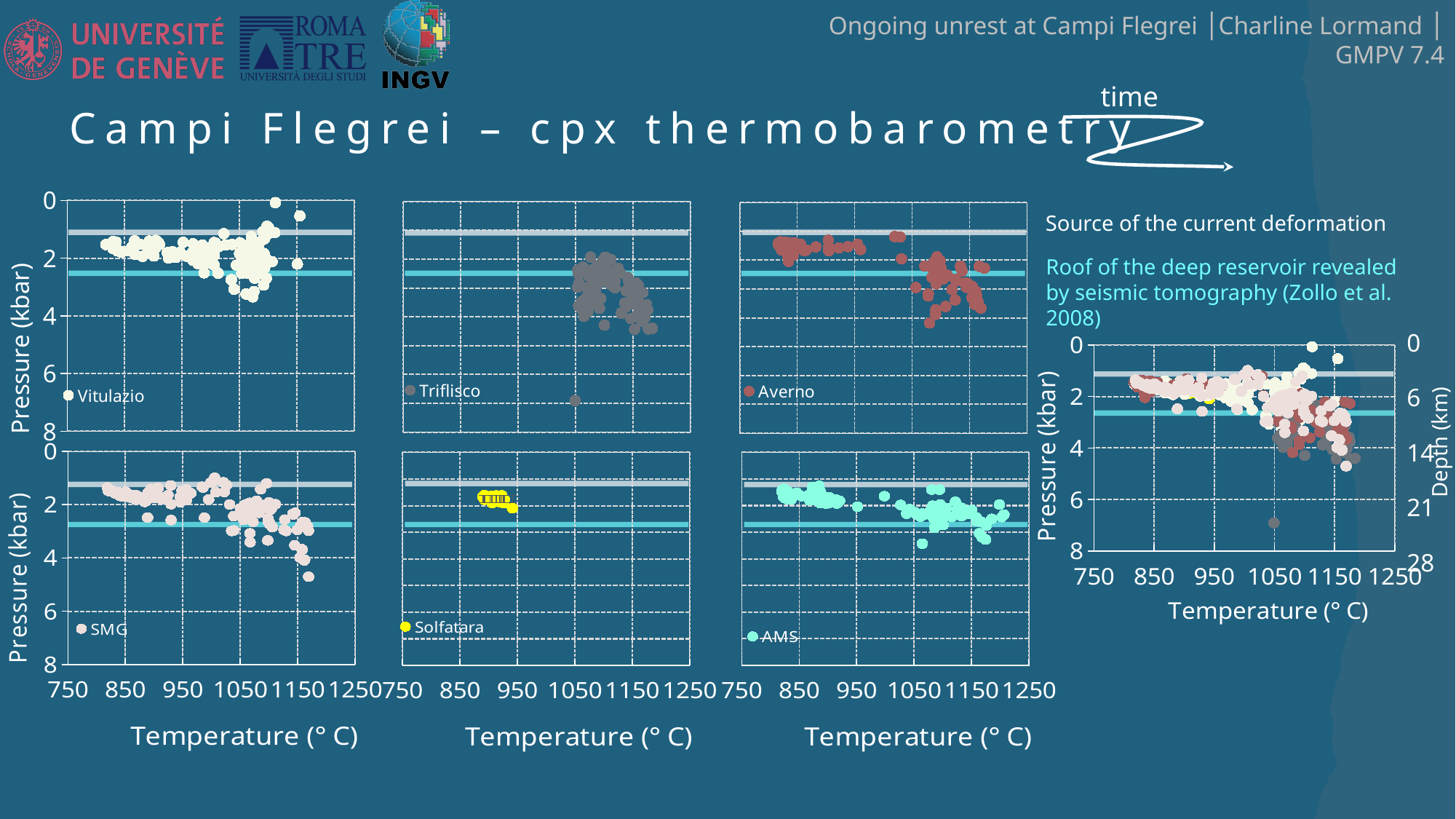
What is the highest value shown on the Depth (km) axis of the combined chart on the right? 28 What is the legend label of the bottom-left chart? SMG Which site's points are plotted in yellow? Solfatara In the Triflisco chart, are most of the plotted temperatures greater or less than 950 °C? greater How many charts are on the slide in total, counting the large combined chart on the right? 7 Which site's points are plotted at higher temperatures, Solfatara or Triflisco? Triflisco What is the highest value shown on the Pressure (kbar) axis of the small charts? 8 In the Solfatara chart, are the plotted temperatures greater or less than 1050 °C? less In the Solfatara chart, are the plotted pressure values greater or less than 4 kbar? less What kind of chart is the top-left chart labelled Vitulazio? scatter chart